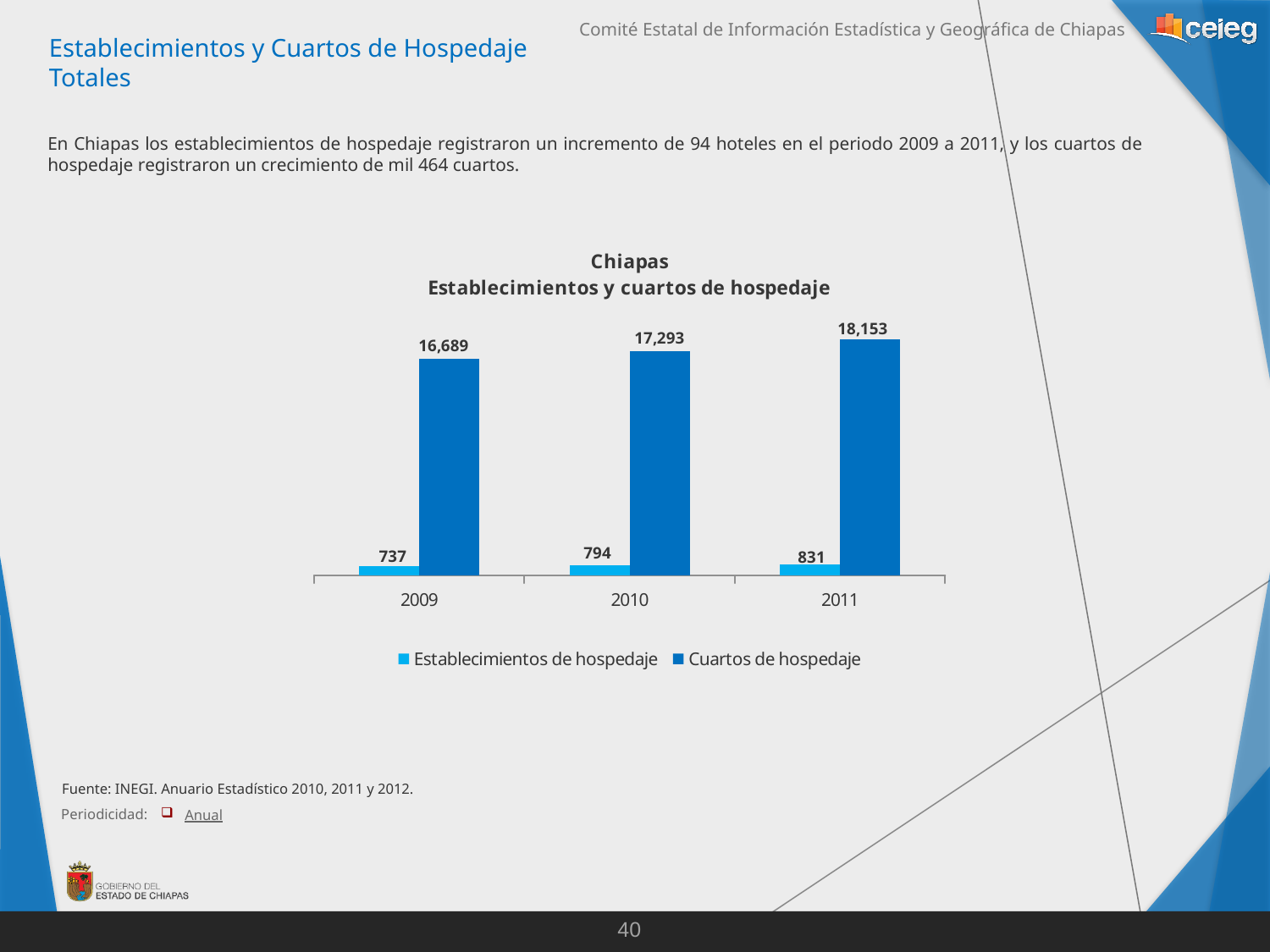
What is the value for Cuartos de hospedaje in 2009? 16,689 Which is larger: Establecimientos de hospedaje in 2010 or in 2011? 2011 What is the value for Establecimientos de hospedaje in 2011? 831 What is the difference between Establecimientos de hospedaje in 2010 and in 2009? 57 What kind of chart is shown? Bar chart How many years are shown on the x axis? 3 What is the difference between Cuartos de hospedaje in 2011 and in 2009? 1,464 How many series does the legend list? 2 What is the value for Establecimientos de hospedaje in 2009? 737 What is the value for Cuartos de hospedaje in 2010? 17,293 Which year has the highest value for Cuartos de hospedaje? 2011 Which year has the lowest value for Establecimientos de hospedaje? 2009